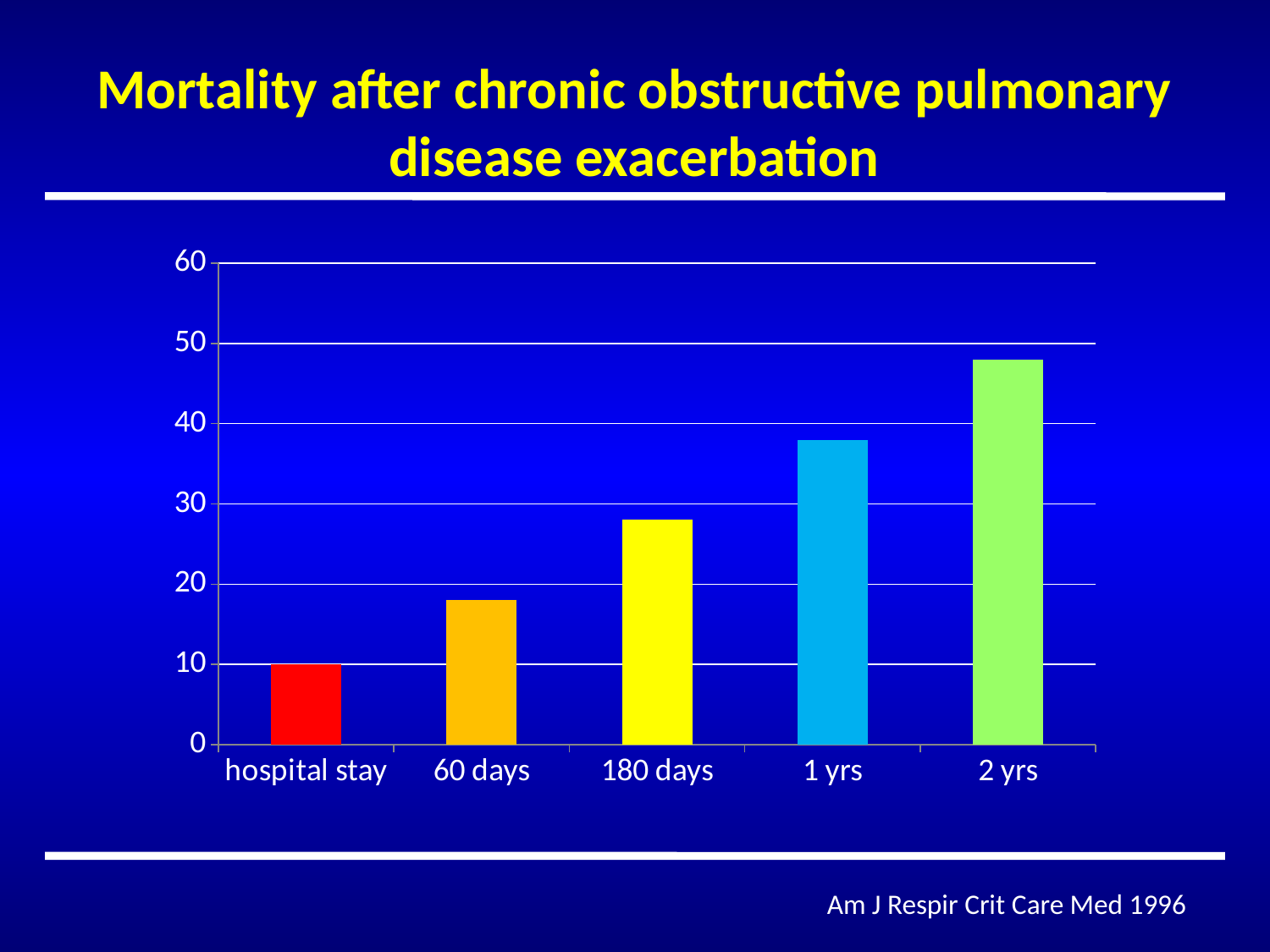
How many categories are shown on the x axis of the chart? 5 What is the value for hospital stay in the chart? 10 Do the values rise or fall from hospital stay to 2 yrs along the x axis? rise Which category has the lowest bar in the chart? hospital stay Which category has the highest bar in the chart? 2 yrs Is the value for 1 yrs greater or less than 40? less What is the title of the slide containing the chart? Mortality after chronic obstructive pulmonary disease exacerbation Is the value for 2 yrs greater or less than 40? greater Is the value for 60 days greater or less than 20? less What kind of chart is shown on the slide? bar chart Which is larger, the value for 180 days or the value for 1 yrs? 1 yrs